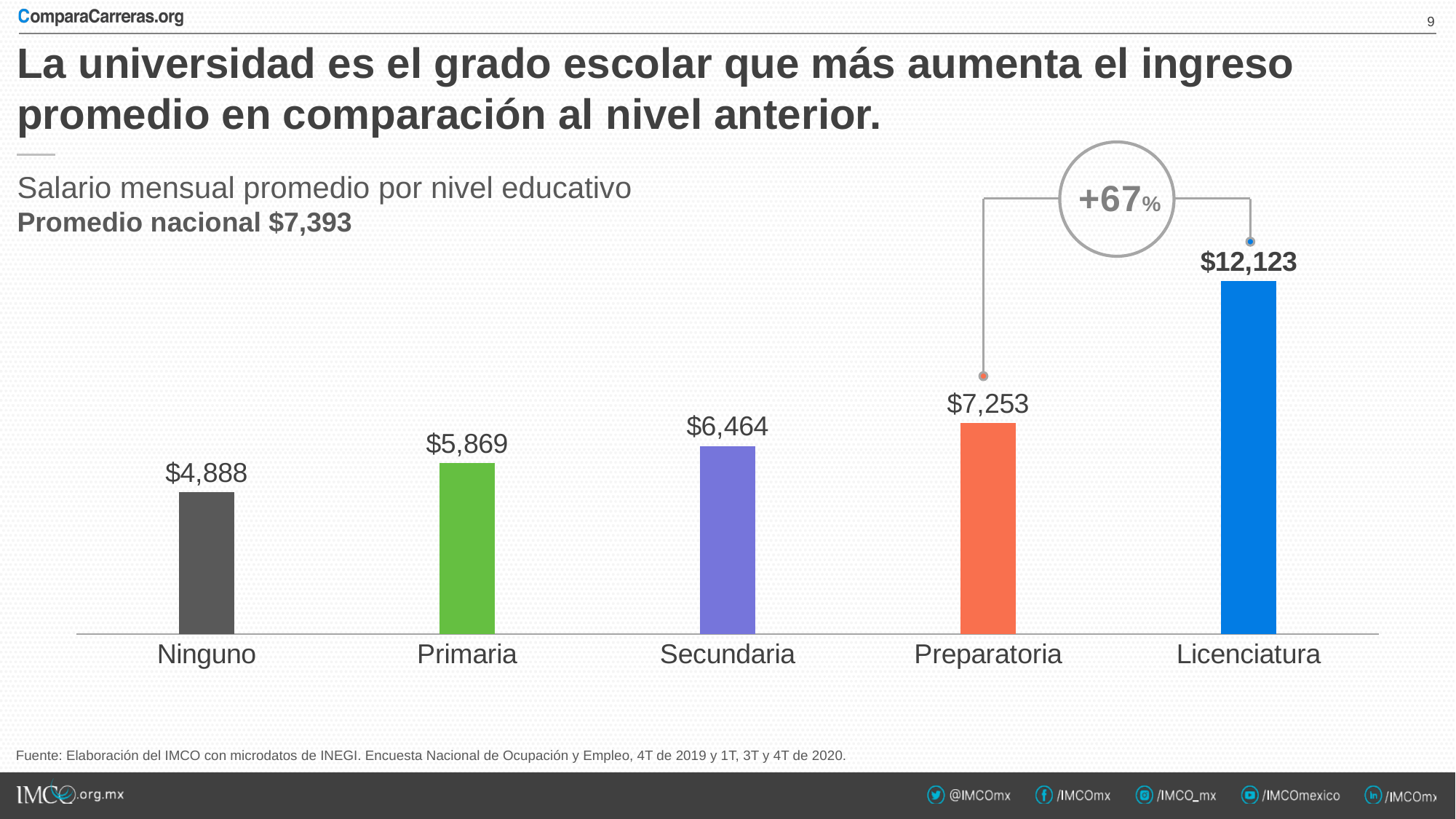
Which education level has the highest average monthly salary? Licenciatura What is the difference in average monthly salary between Primaria and Ninguno? $981 What is the average monthly salary for Ninguno? $4,888 What is the average monthly salary for Secundaria? $6,464 How many education levels are shown in the chart? 5 What is the average monthly salary for Licenciatura? $12,123 Do the salary values rise or fall from Ninguno to Licenciatura? Rise What percentage increase is annotated between Preparatoria and Licenciatura? +67% What type of chart is shown on the slide? Bar chart Which has a higher average monthly salary, Secundaria or Preparatoria? Preparatoria What is the difference in average monthly salary between Licenciatura and Preparatoria? $4,870 Which education level has the lowest average monthly salary? Ninguno